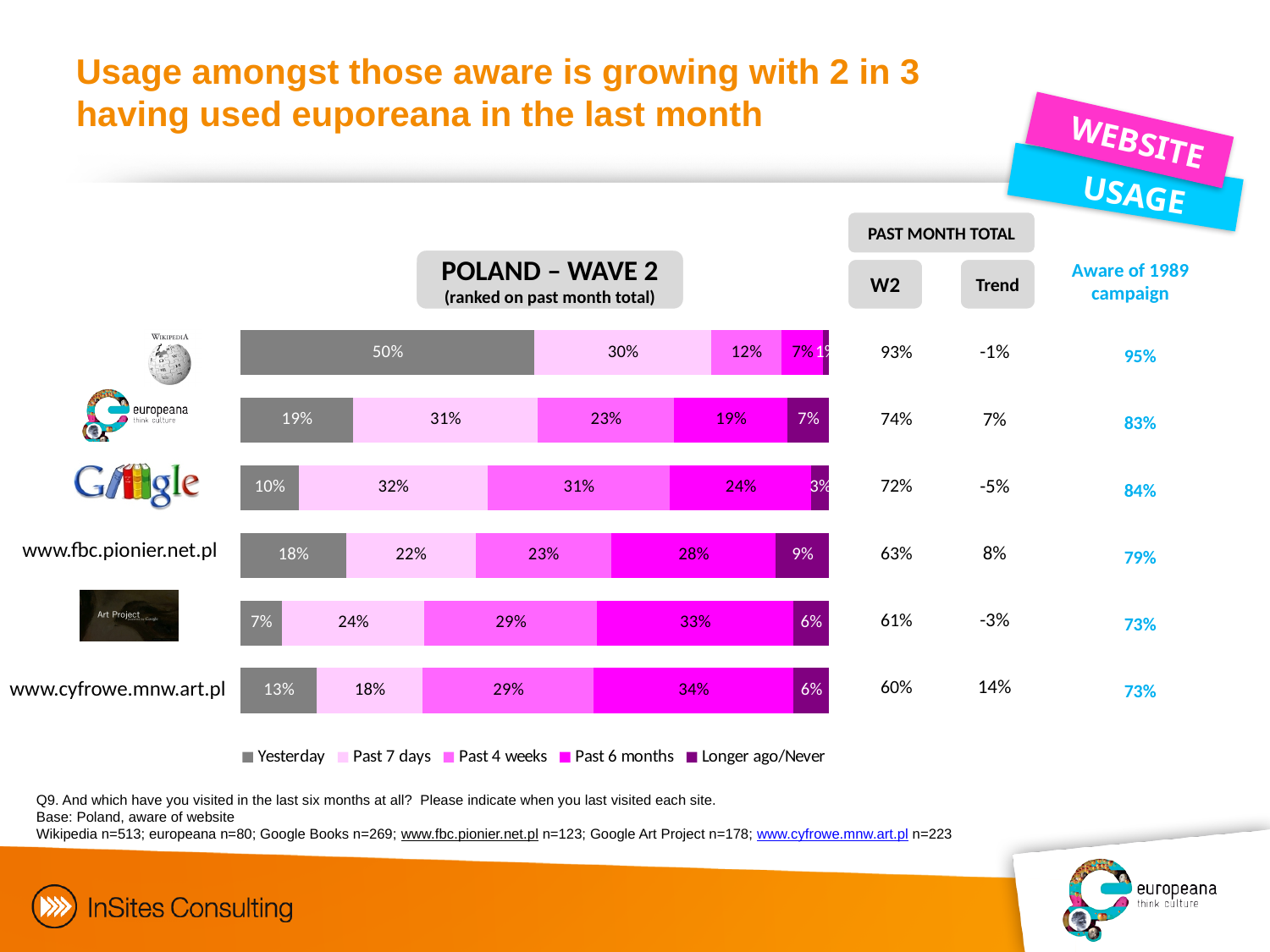
What type of chart is shown on the slide? Stacked bar chart What is the difference between the 'Past 4 weeks' values for Google Books and Wikipedia? 19% Which website has the lowest 'Yesterday' value? Art Project Which website has the highest 'Yesterday' value? Wikipedia What is the 'Longer ago/Never' value for europeana? 7% How many websites are shown in the chart? 6 What percentage of those aware of www.fbc.pionier.net.pl visited it yesterday? 18% What is the title shown above the chart? POLAND – WAVE 2 (ranked on past month total) How many series does the legend list? 5 What is the 'Past 7 days' value for Google Books? 32% Which is larger: the 'Past 7 days' value for europeana or for www.fbc.pionier.net.pl? europeana What is the 'Past 6 months' value for www.cyfrowe.mnw.art.pl? 34%